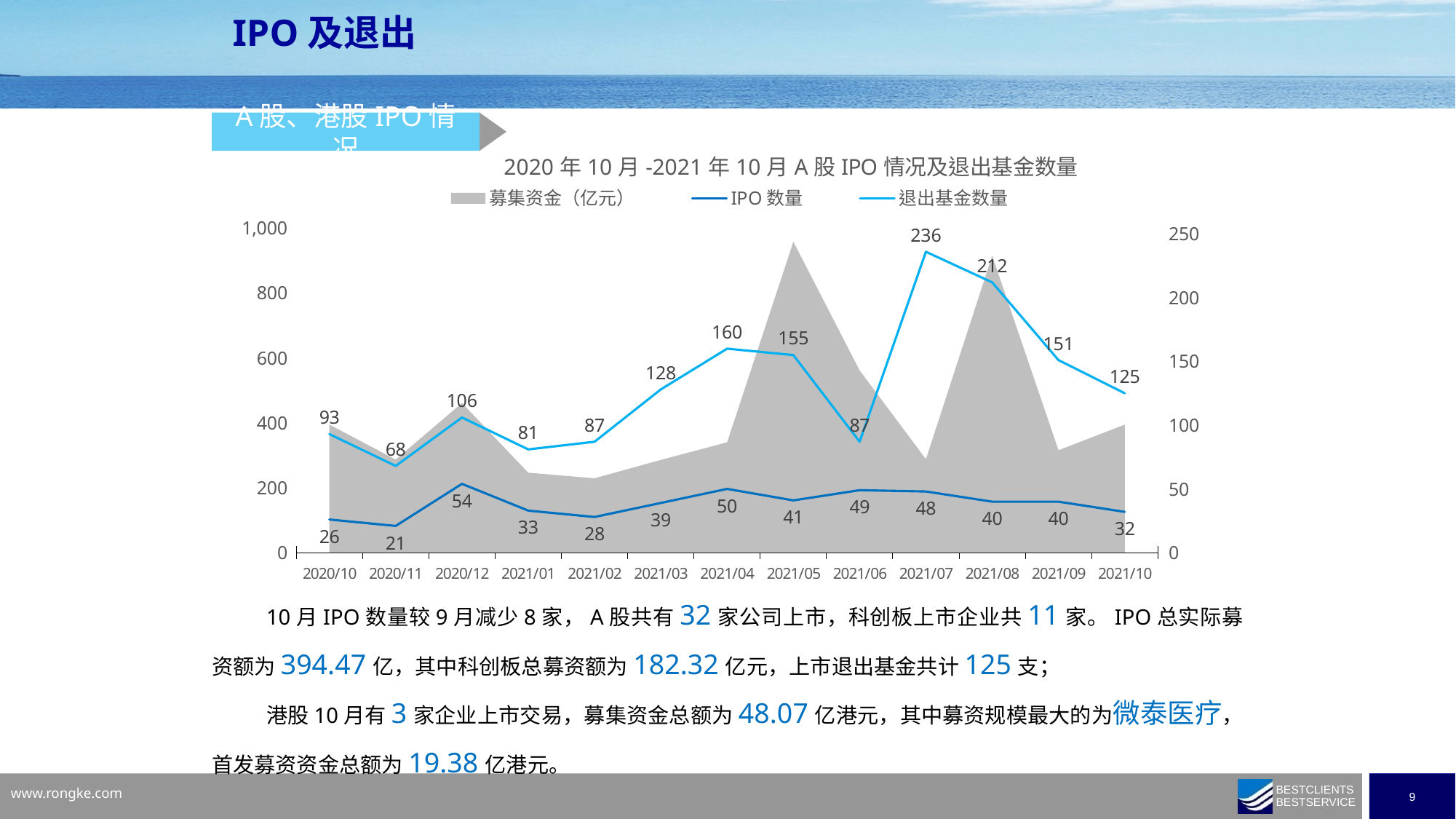
In which month is IPO 数量 lowest? 2020/11 What is the 退出基金数量 value for 2021/07? 236 How many months are shown on the x axis? 13 Which month has the larger 退出基金数量, 2021/08 or 2021/09? 2021/08 How many series does the legend list? 3 In which month is IPO 数量 highest? 2020/12 Is the 募集资金（亿元） value for 2021/05 greater or less than 800? greater What is the difference in IPO 数量 between 2021/09 and 2021/10? 8 In which month is 退出基金数量 highest? 2021/07 What is the IPO 数量 value for 2021/04? 50 Does 退出基金数量 rise or fall from 2021/07 to 2021/10? fall What is the IPO 数量 value for 2020/12? 54